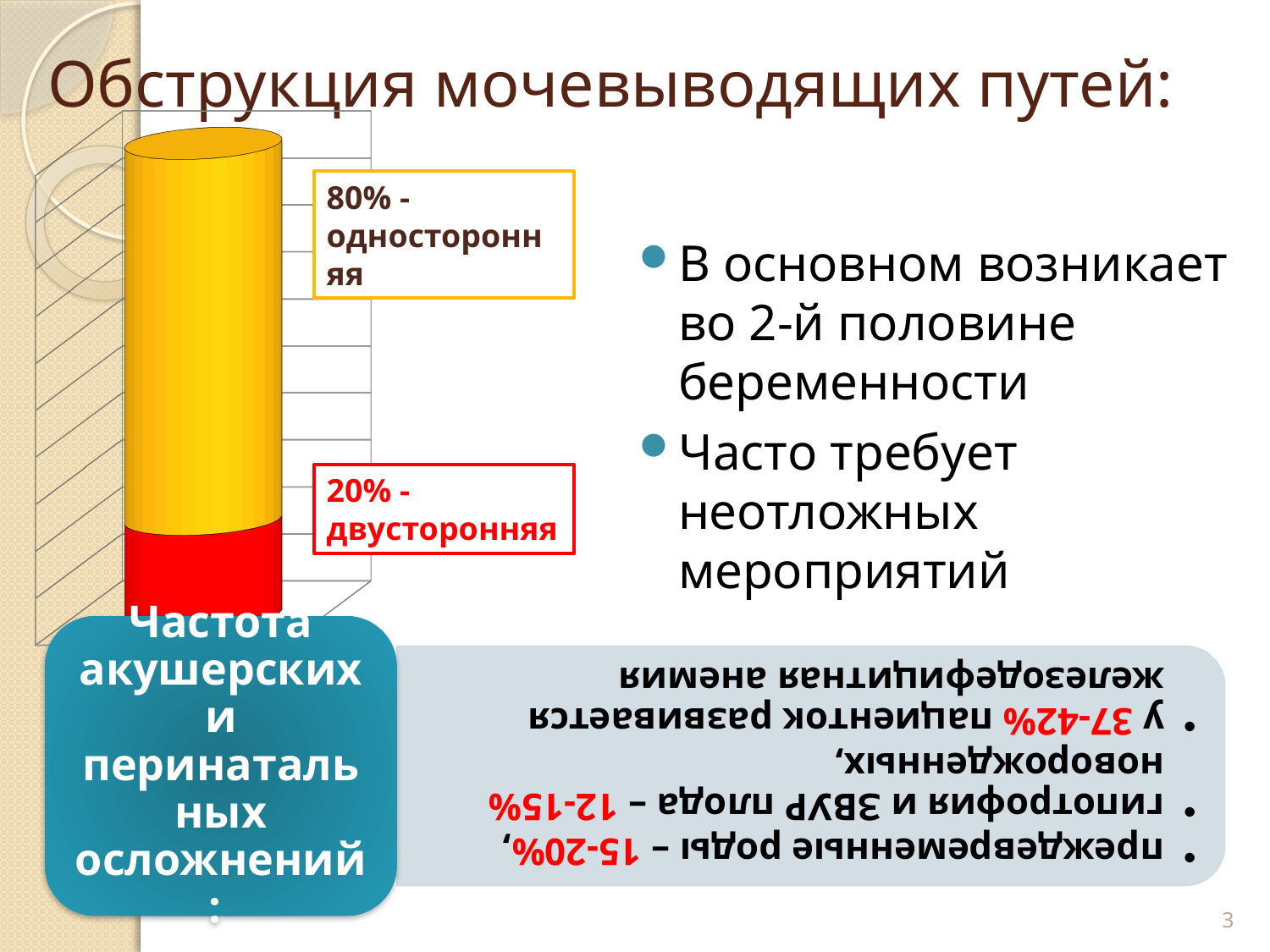
Which segment of the bar is the smallest? двусторонняя Is the value for двусторонняя greater or less than 50%? less What share of urinary tract obstruction is labelled as двусторонняя (bilateral) on the chart? 20% Which segment of the bar is larger: односторонняя or двусторонняя? односторонняя What colour is the segment representing двусторонняя obstruction? red What colour is the segment representing односторонняя obstruction? yellow What is the total of the two segments in the stacked bar? 100% Is the value for односторонняя greater or less than 50%? greater How many segments make up the stacked bar? 2 What share of urinary tract obstruction is labelled as односторонняя (unilateral) on the chart? 80% By how many percentage points does односторонняя exceed двусторонняя? 60 What kind of chart is shown on the slide? bar chart